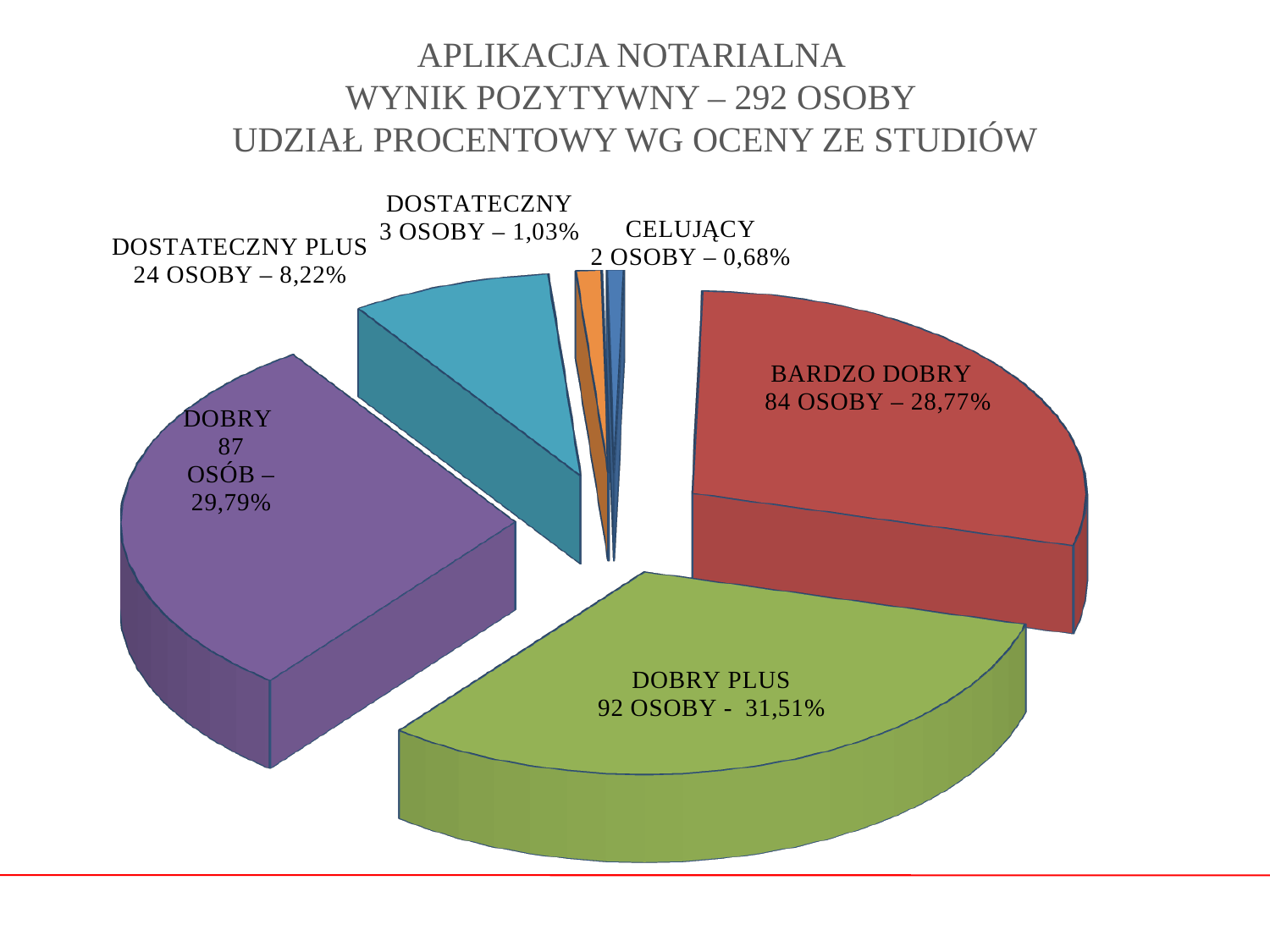
How many people are in the DOSTATECZNY category? 3 What percentage share does the DOSTATECZNY PLUS slice have? 8,22% Which category has the smallest share of the pie? CELUJĄCY Which category has the largest share of the pie? DOBRY PLUS What percentage share does the DOBRY PLUS slice have? 31,51% Which category has more people, DOBRY or DOSTATECZNY PLUS? DOBRY What kind of chart is shown on the slide? pie chart How many people are in the BARDZO DOBRY category? 84 What colour is the DOBRY slice? purple What is the total number of people with a positive result according to the chart title? 292 How many more people are in DOBRY PLUS than in BARDZO DOBRY? 8 How many slices does the pie chart have? 6